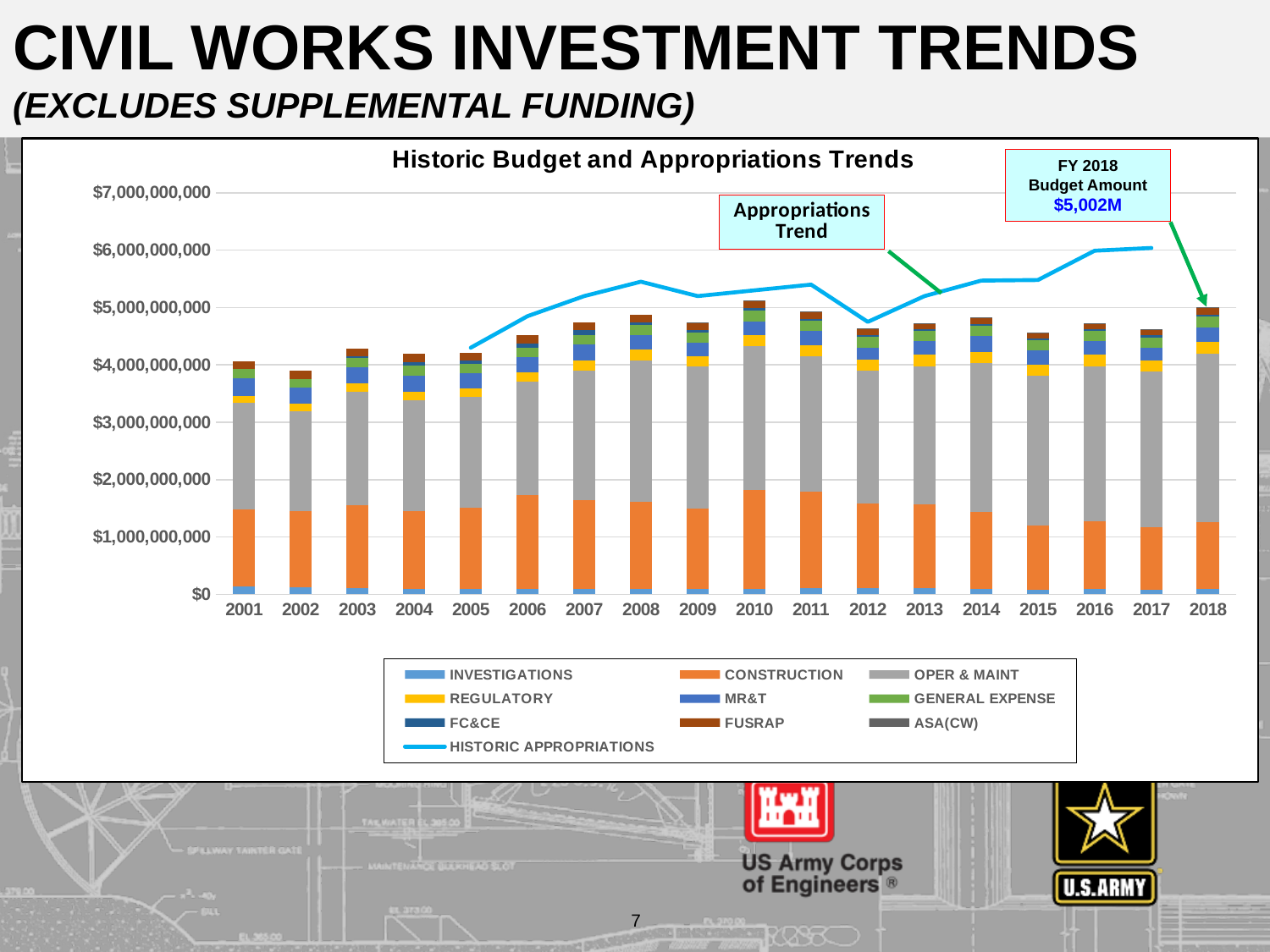
Is the total stacked bar for 2010 greater or less than $5,000,000,000? greater How many years are shown along the x axis of the chart? 18 What is the title of the chart? Historic Budget and Appropriations Trends What FY 2018 budget amount is called out on the chart? $5,002M Which year has the lowest total stacked bar? 2002 Which is larger, the CONSTRUCTION segment in 2010 or in 2017? 2010 Is the HISTORIC APPROPRIATIONS line value for 2012 greater or less than $5,000,000,000? less Is the HISTORIC APPROPRIATIONS line value for 2008 greater or less than $5,000,000,000? greater Which legend entry is plotted as a line rather than as bars? HISTORIC APPROPRIATIONS How many series does the chart's legend list? 10 What kind of chart is shown on the slide? stacked bar chart with a line